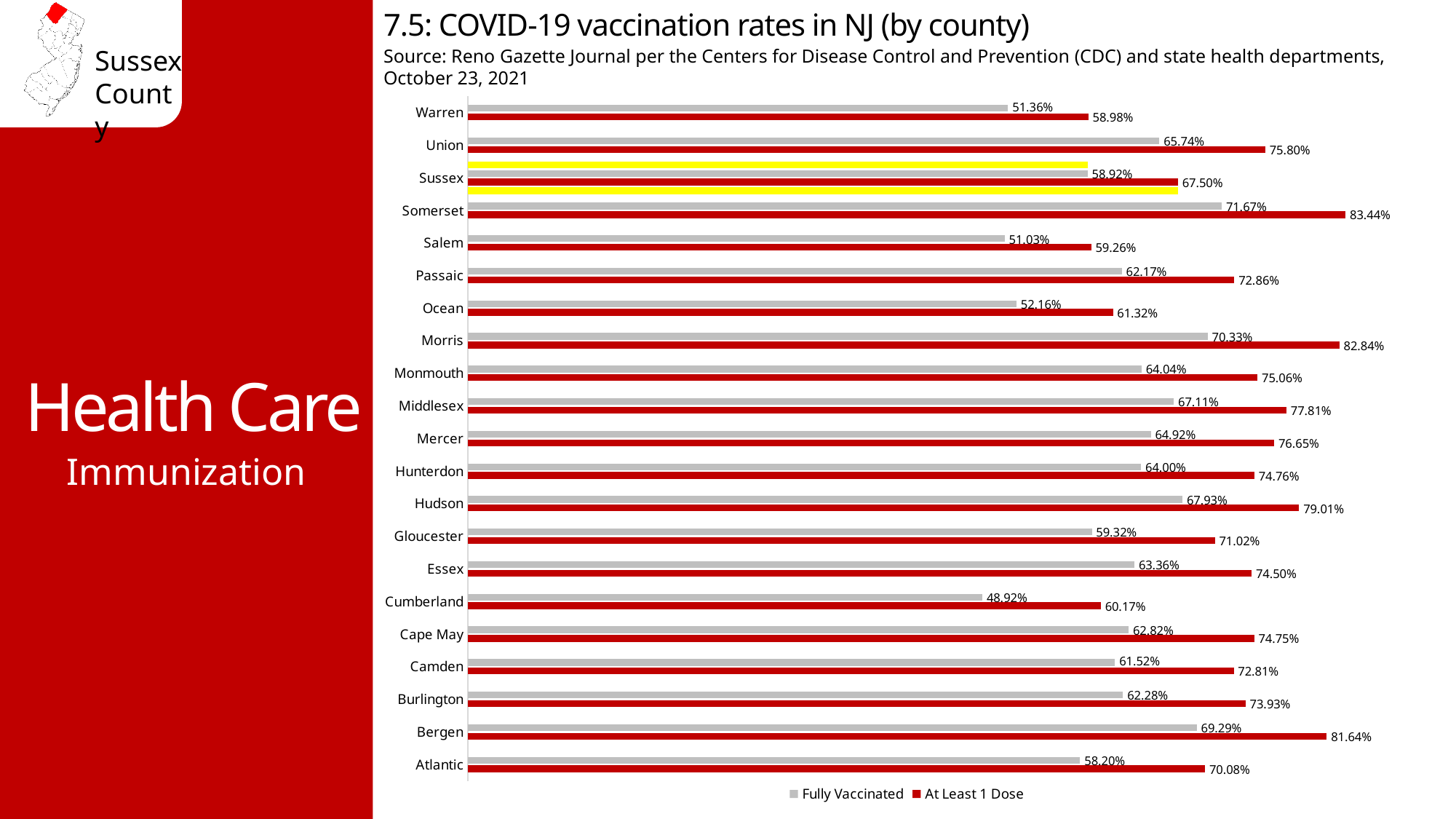
What is the Fully Vaccinated rate for Sussex county? 58.92% What is the At Least 1 Dose rate for Cumberland county? 60.17% Which county's bars are highlighted in yellow on the chart? Sussex Which county has the lowest Fully Vaccinated rate? Cumberland Which county has the larger Fully Vaccinated rate, Morris or Bergen? Morris Which county has the highest Fully Vaccinated rate? Somerset How many counties are shown in the chart? 21 Which county has the highest At Least 1 Dose rate? Somerset How many series does the legend list? 2 What kind of chart is shown on the slide? Bar chart What is the At Least 1 Dose rate for Somerset county? 83.44% What is the difference between the At Least 1 Dose rate and the Fully Vaccinated rate for Sussex county? 8.58 percentage points